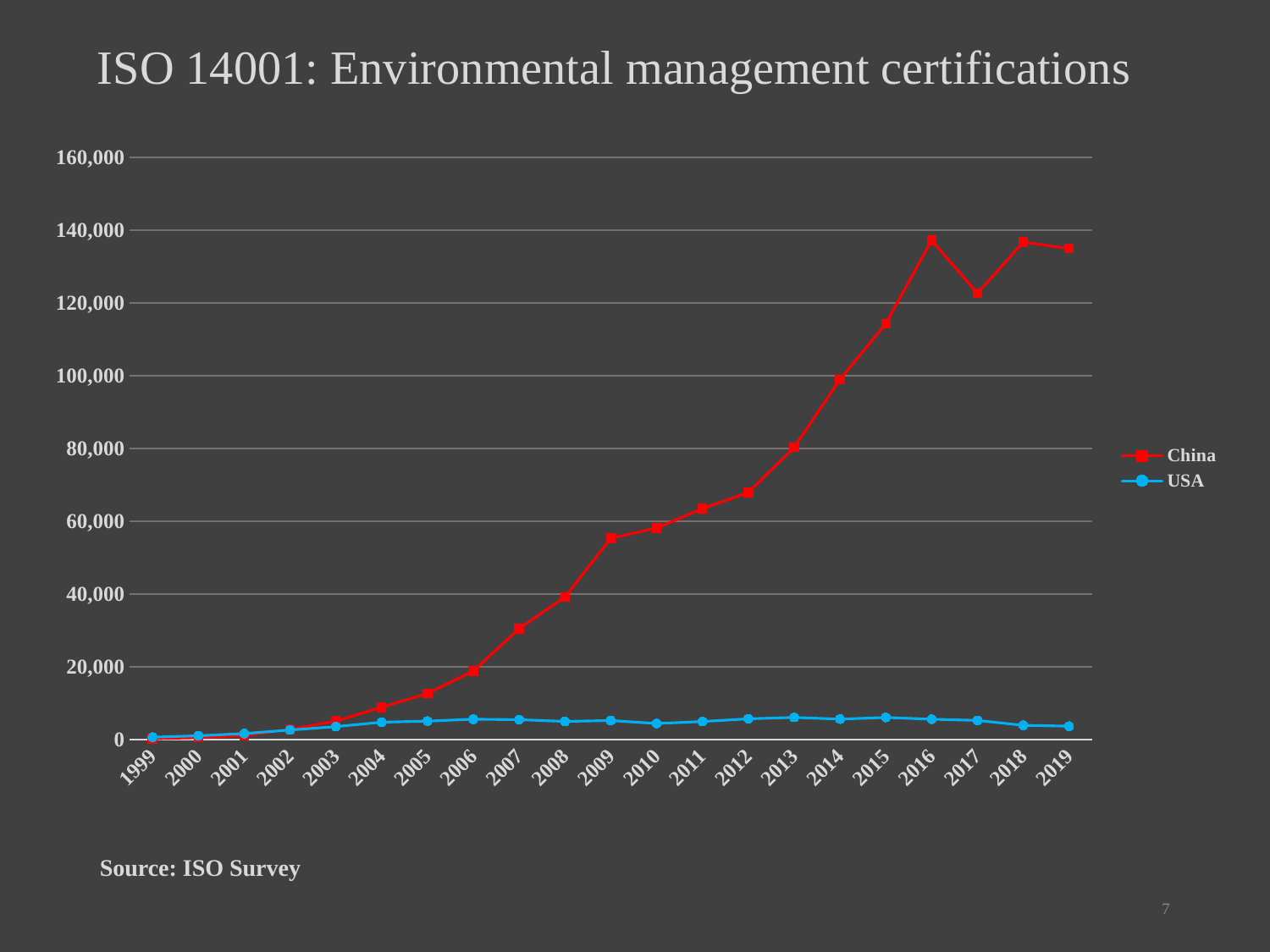
Which series has the larger value in 2019, China or USA? China Is the value for China in 2016 greater or less than 120,000? greater What is the title of the chart? ISO 14001: Environmental management certifications Is the value for China in 2009 greater or less than 40,000? greater Does the China series generally rise or fall from 1999 to 2016? rise Is the value for USA in 2015 greater or less than 20,000? less In which year does the China series reach its highest value? 2016 What kind of chart is shown on the slide? line chart How many series does the legend list? 2 How many years are plotted along the x axis? 21 Which two series are shown in the legend? China and USA